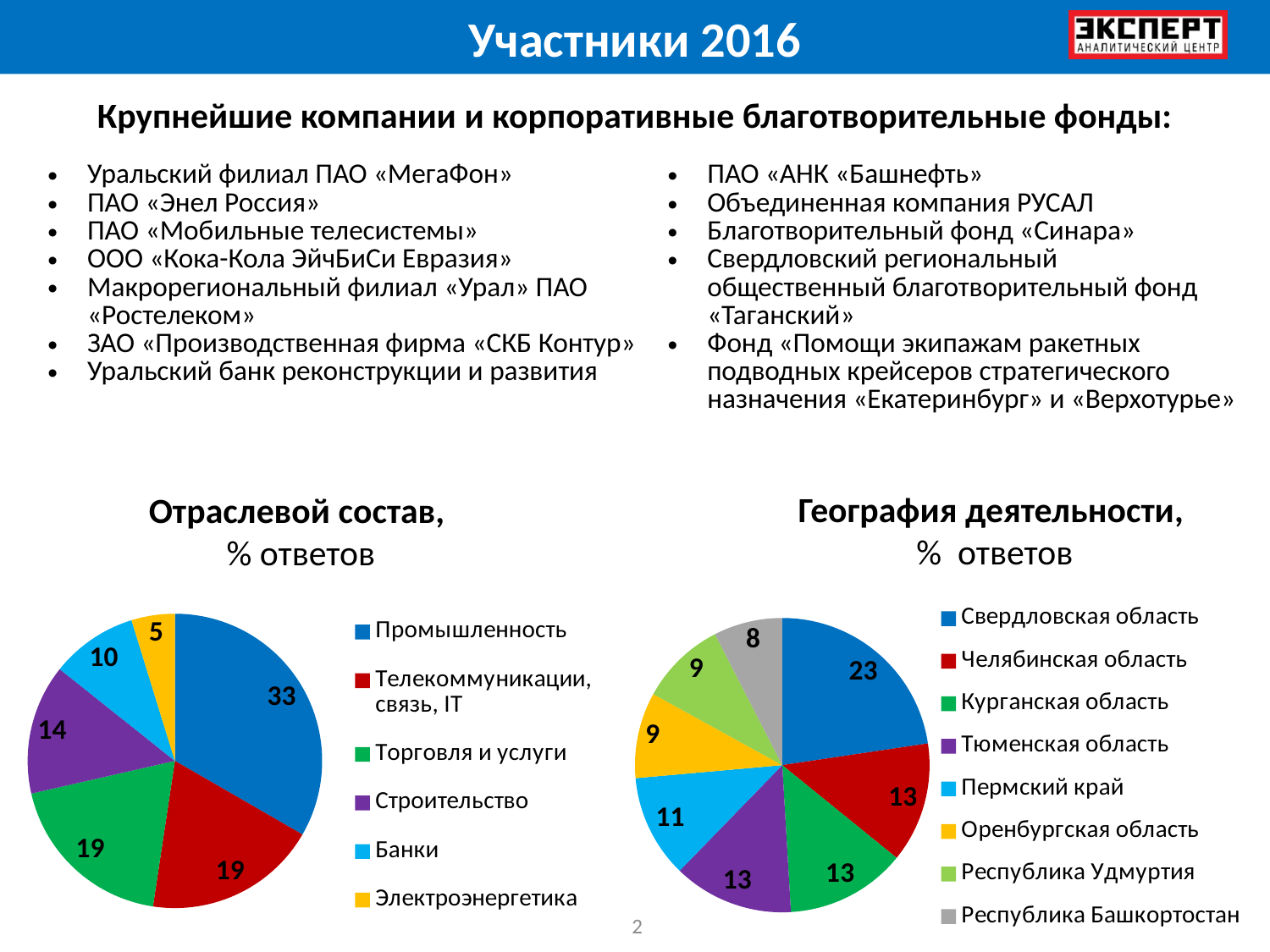
In the 'Отраслевой состав' chart, what is the difference between Промышленность and Банки? 23 In the 'Отраслевой состав' chart, what is the value for Строительство? 14 How many categories does the 'Отраслевой состав' chart show? 6 In the 'География деятельности' chart, what is the value for Свердловская область? 23 In the 'Отраслевой состав' chart, what is the value for Промышленность? 33 In the 'Отраслевой состав' chart, which category has the smallest slice? Электроэнергетика What type of chart is the 'Отраслевой состав' chart? pie chart In the 'География деятельности' chart, which is larger: Пермский край or Республика Башкортостан? Пермский край In the 'География деятельности' chart, what is the difference between Свердловская область and Оренбургская область? 14 In the 'География деятельности' chart, which region has the largest slice? Свердловская область How many regions does the legend of the 'География деятельности' chart list? 8 In the 'География деятельности' chart, what is the value for Пермский край? 11